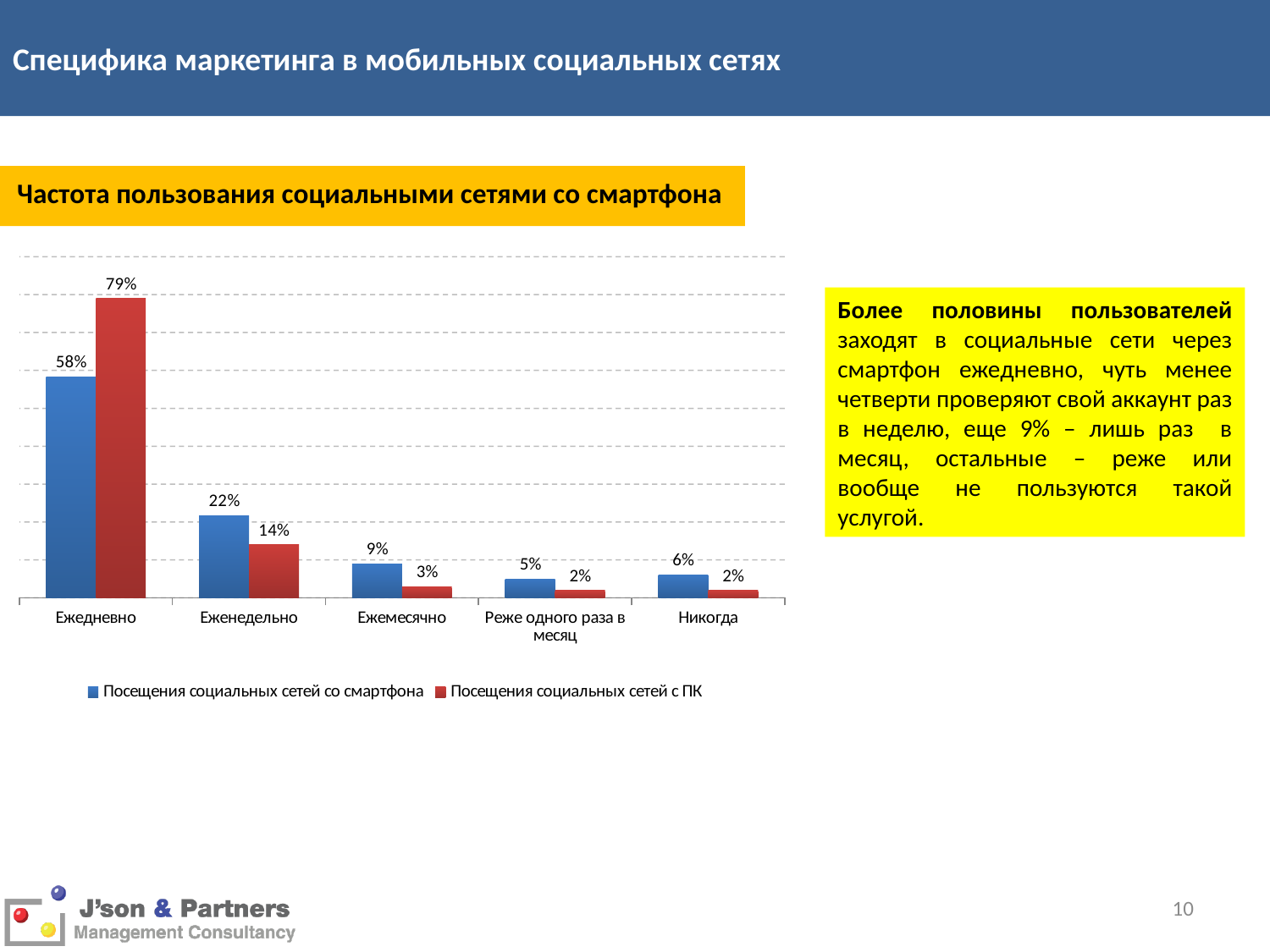
What is the value for Ежедневно in the series Посещения социальных сетей со смартфона? 58% How many series does the chart legend list? 2 What is the title of the chart? Частота пользования социальными сетями со смартфона What is the value for Ежемесячно in the series Посещения социальных сетей со смартфона? 9% Which category has the lowest value in the series Посещения социальных сетей с ПК? Реже одного раза в месяц and Никогда (both 2%) What is the value for Ежедневно in the series Посещения социальных сетей с ПК? 79% For Еженедельно, which series has the larger value: Посещения социальных сетей со смартфона or Посещения социальных сетей с ПК? Посещения социальных сетей со смартфона How many categories are shown on the x axis of the chart? 5 What is the difference between the Посещения социальных сетей с ПК and Посещения социальных сетей со смартфона values for Ежедневно? 21% Which category has the highest value in the series Посещения социальных сетей со смартфона? Ежедневно What kind of chart is shown on the slide? Bar chart What is the value for Еженедельно in the series Посещения социальных сетей с ПК? 14%